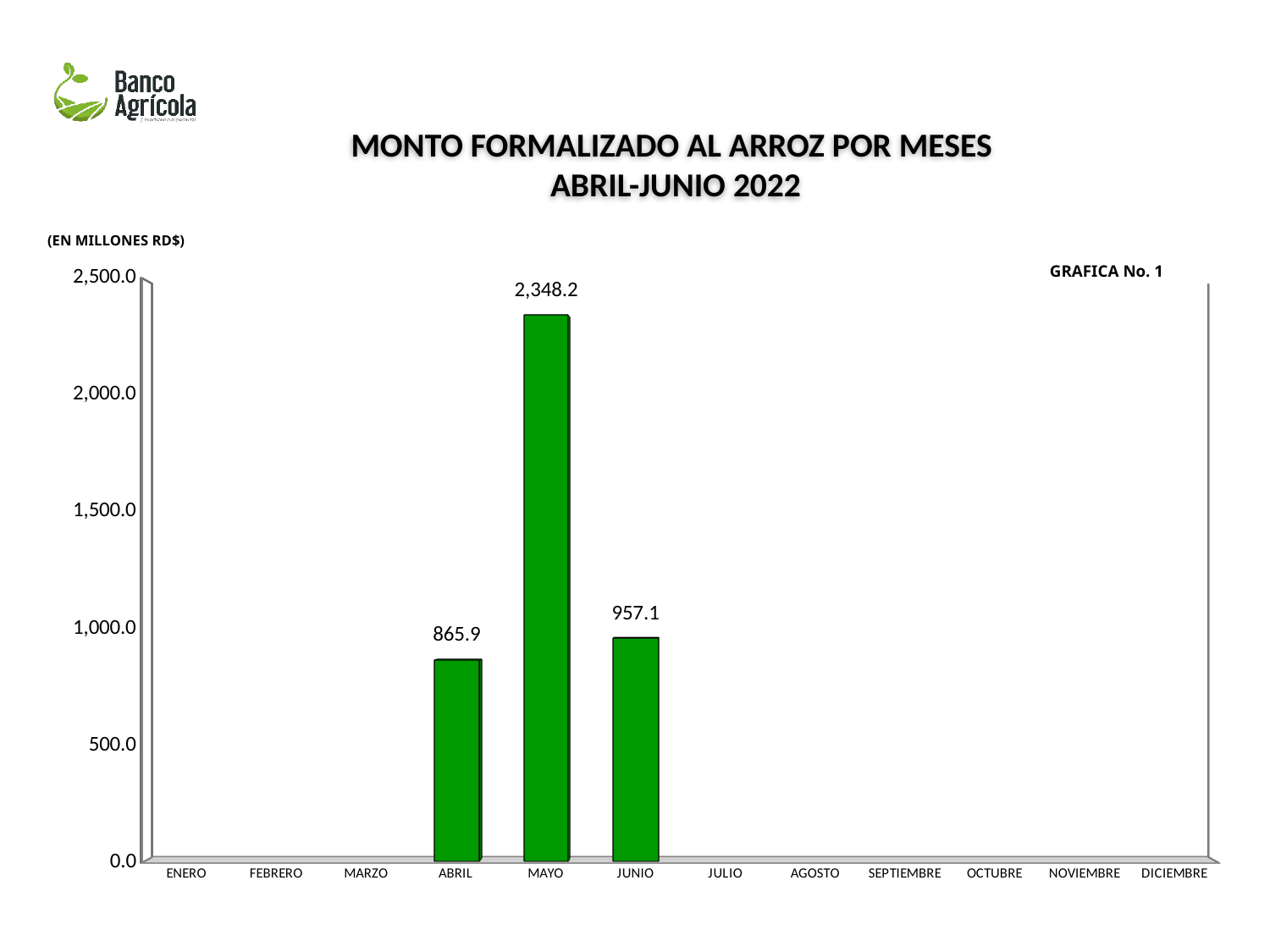
In what units are the values expressed, according to the label above the chart? EN MILLONES RD$ What is the difference between the values for MAYO and ABRIL? 1,482.3 What is the value for MAYO? 2,348.2 Which month has the highest value? MAYO Among the months with a plotted bar, which has the lowest value? ABRIL Is the value for MAYO greater or less than 2,000.0? greater What is the value for ABRIL? 865.9 Which is larger, the value for JUNIO or the value for ABRIL? JUNIO What kind of chart is shown on the slide? bar chart What is the value for JUNIO? 957.1 What is the difference between the values for JUNIO and ABRIL? 91.2 How many month categories are shown on the x axis? 12